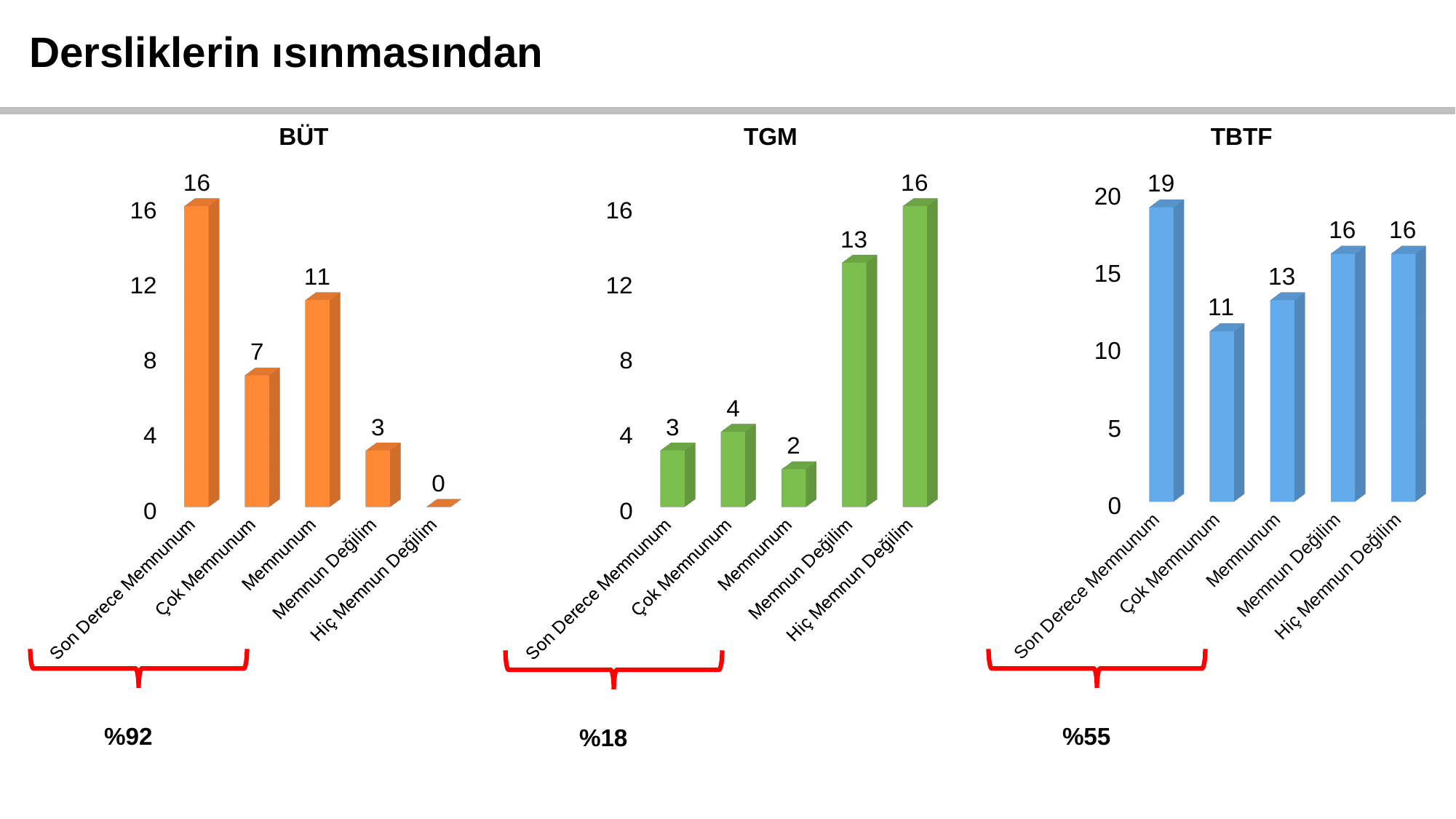
In the TGM chart, which is larger, Çok Memnunum or Memnunum? Çok Memnunum In the TBTF chart, what is the value for Çok Memnunum? 11 In the TGM chart, which category has the highest value? Hiç Memnun Değilim In the BÜT chart, which category has the lowest value? Hiç Memnun Değilim What kind of chart is the BÜT chart? Bar chart In the BÜT chart, what is the value for Son Derece Memnunum? 16 In the TGM chart, what is the value for Memnun Değilim? 13 What colour are the bars in the TBTF chart? Blue In the TBTF chart, which category has the highest value? Son Derece Memnunum How many categories does the TGM chart show? 5 In the BÜT chart, what is the difference between Son Derece Memnunum and Çok Memnunum? 9 In the TBTF chart, what is the difference between Son Derece Memnunum and Memnunum? 6